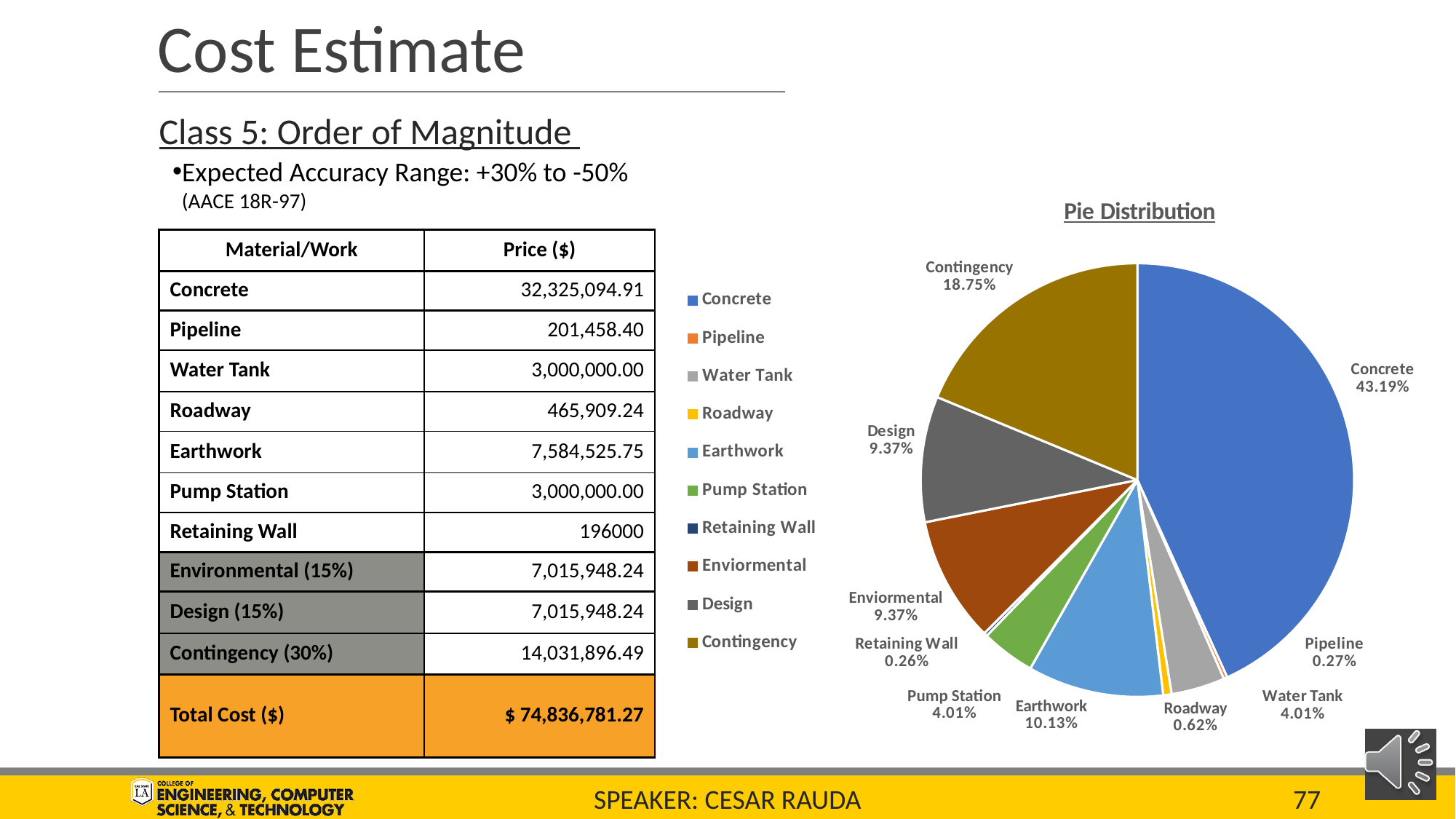
How many entries does the legend of the Pie Distribution chart list? 10 In the Pie Distribution chart, which is larger: the share for Earthwork or the share for Design? Earthwork In the Pie Distribution chart, what percentage is shown for Contingency? 18.75% What kind of chart is shown on the right side of the slide? Pie chart What is the title of the pie chart on the slide? Pie Distribution Which category has the smallest labelled share in the Pie Distribution chart? Retaining Wall In the Pie Distribution chart, what percentage is labelled for Earthwork? 10.13% In the Pie Distribution chart, what share does Concrete have? 43.19% In the Pie Distribution chart, what share does Roadway have? 0.62% In the Pie Distribution chart, what is the difference in percentage points between Contingency and Earthwork? 8.62% In the Pie Distribution chart, how many slices (categories) are there? 10 Which category has the largest slice in the Pie Distribution chart? Concrete